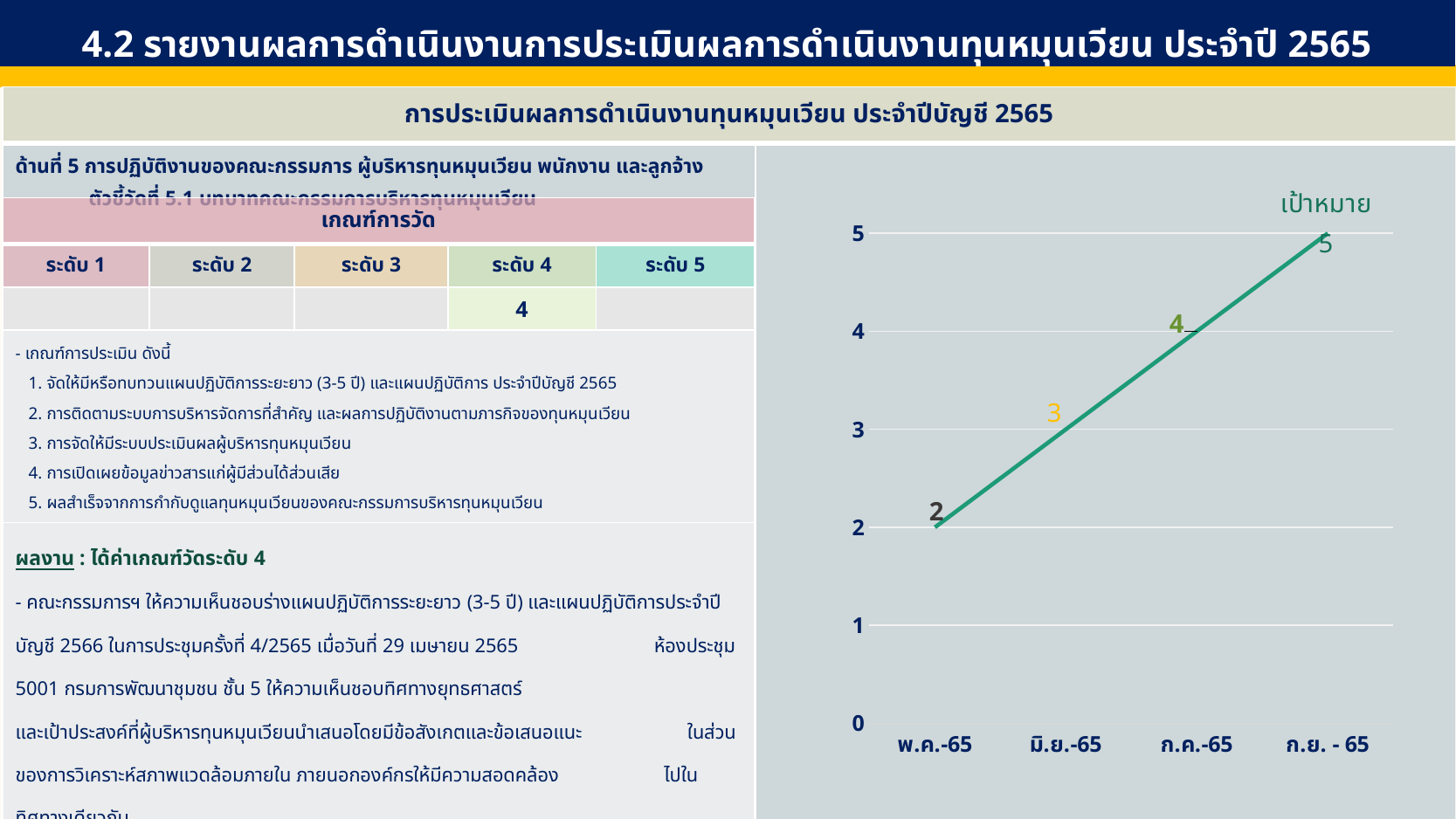
Which is larger on the line chart, the value for ก.ค.-65 or the value for มิ.ย.-65? ก.ค.-65 What is the value for ก.ย. - 65 on the line chart? 5 Do the values on the line chart rise or fall from left to right along the x axis? rise What is the value for พ.ค.-65 on the line chart? 2 What kind of chart is shown on the right side of the slide? line chart How many categories are shown on the x axis of the line chart? 4 Which category has the lowest value on the line chart? พ.ค.-65 Which category has the highest value on the line chart? ก.ย. - 65 What is the value for ก.ค.-65 on the line chart? 4 What is the value for มิ.ย.-65 on the line chart? 3 What is the difference between the values for ก.ย. - 65 and พ.ค.-65 on the line chart? 3